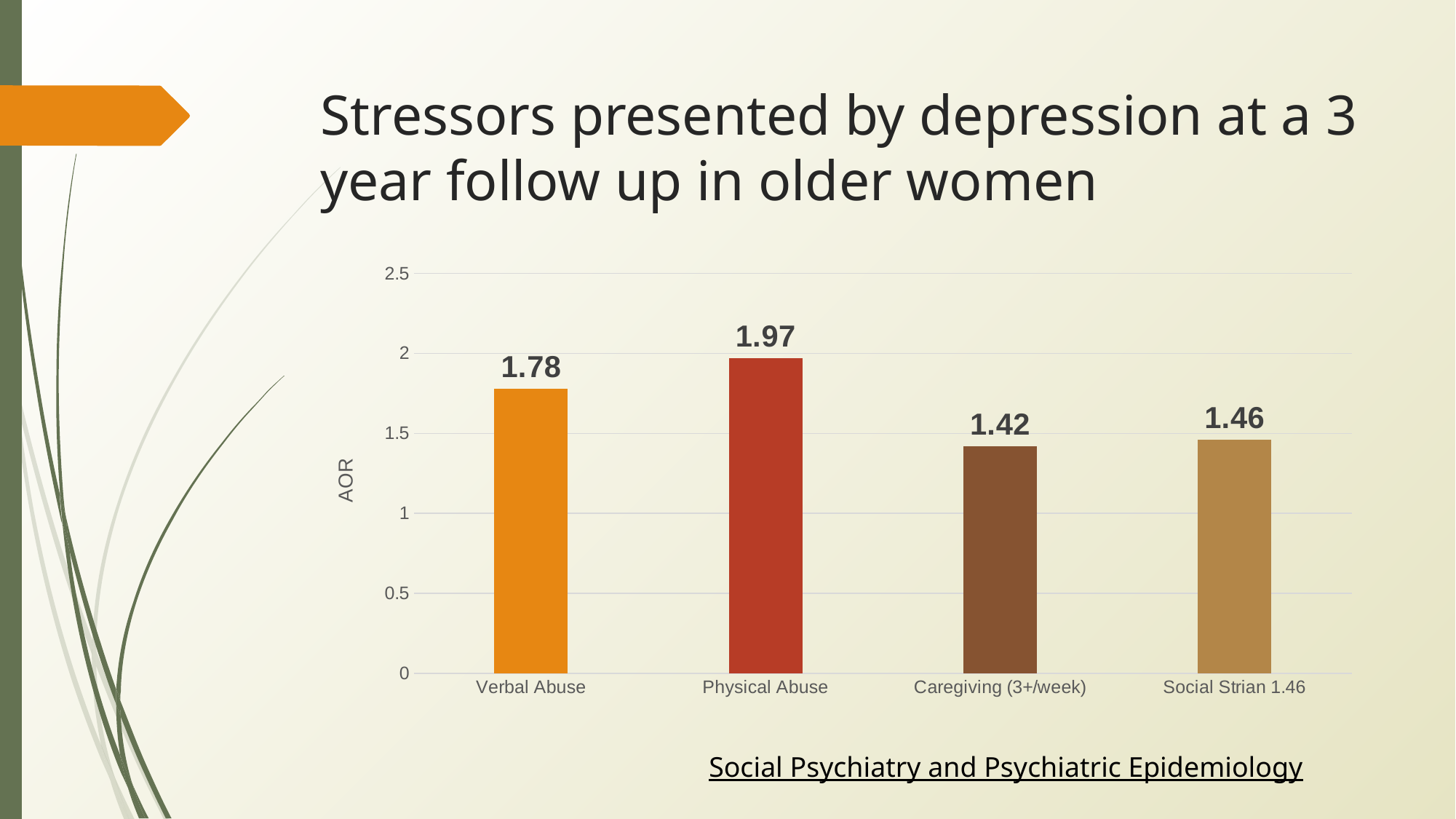
Is the AOR value for Physical Abuse greater or less than 1.5? greater What is the AOR value for Physical Abuse? 1.97 What is the label on the vertical axis of the chart? AOR Which stressor has the highest AOR? Physical Abuse What kind of chart is shown on the slide? Bar chart Which has a larger AOR, Verbal Abuse or Physical Abuse? Physical Abuse How many stressor categories are shown in the chart? 4 What is the difference between the AOR for Verbal Abuse and Caregiving (3+/week)? 0.36 What is the AOR value for Caregiving (3+/week)? 1.42 What is the AOR value for Verbal Abuse? 1.78 What is the difference between the AOR for Physical Abuse and Verbal Abuse? 0.19 Which stressor has the lowest AOR? Caregiving (3+/week)